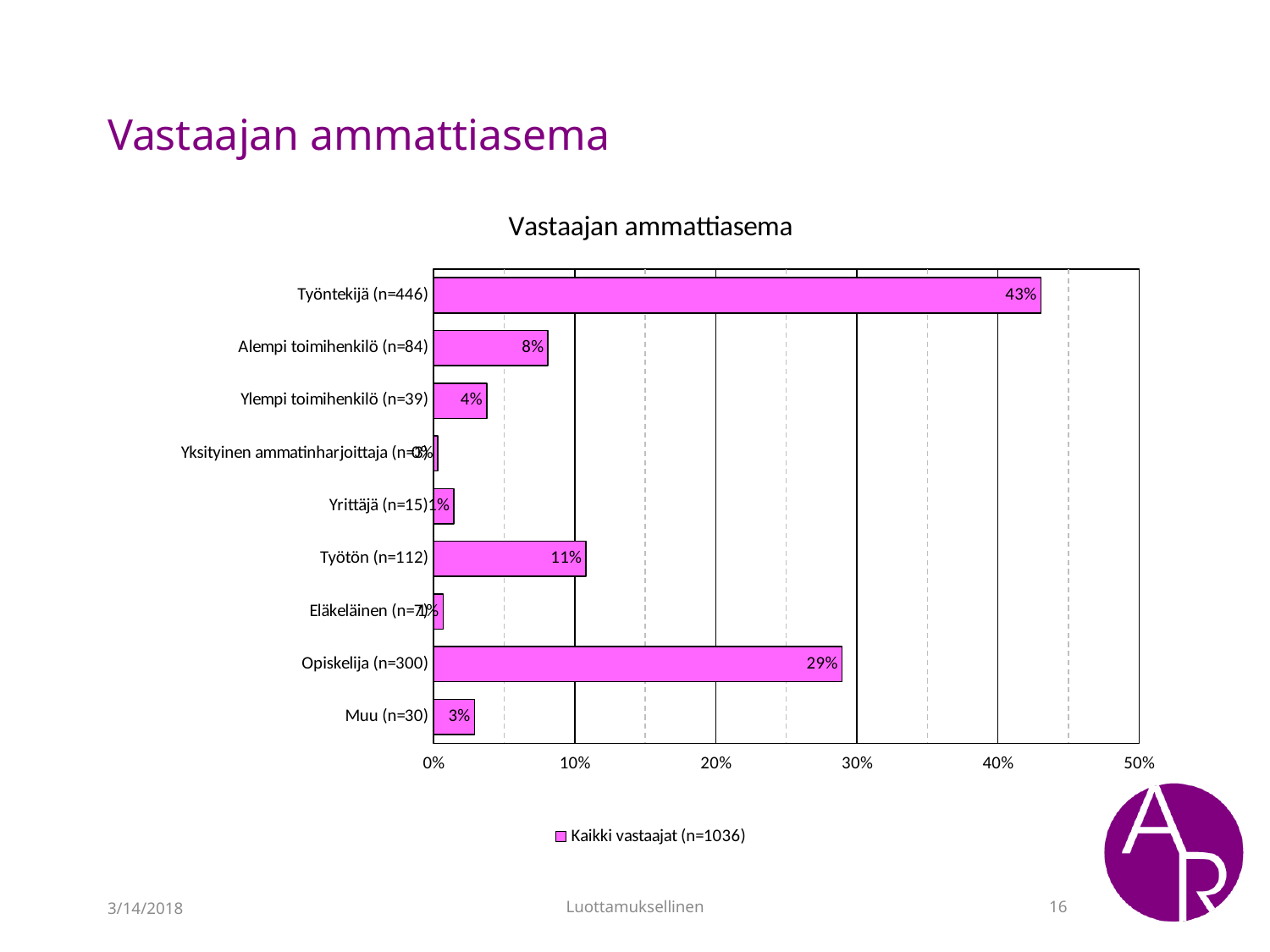
Is the value for Opiskelija (n=300) greater or less than 20%? greater Which category has the highest value? Työntekijä (n=446) What is the value for Työtön (n=112)? 11% What kind of chart is shown on the slide? bar chart What series does the legend list? Kaikki vastaajat (n=1036) Which is larger, the value for Työtön (n=112) or the value for Ylempi toimihenkilö (n=39)? Työtön (n=112) How many categories are shown on the chart? 9 What is the value for Alempi toimihenkilö (n=84)? 8% What is the value for Muu (n=30)? 3% What is the difference between the values for Työntekijä (n=446) and Opiskelija (n=300)? 14% What is the value for Opiskelija (n=300)? 29% What is the value for Työntekijä (n=446)? 43%